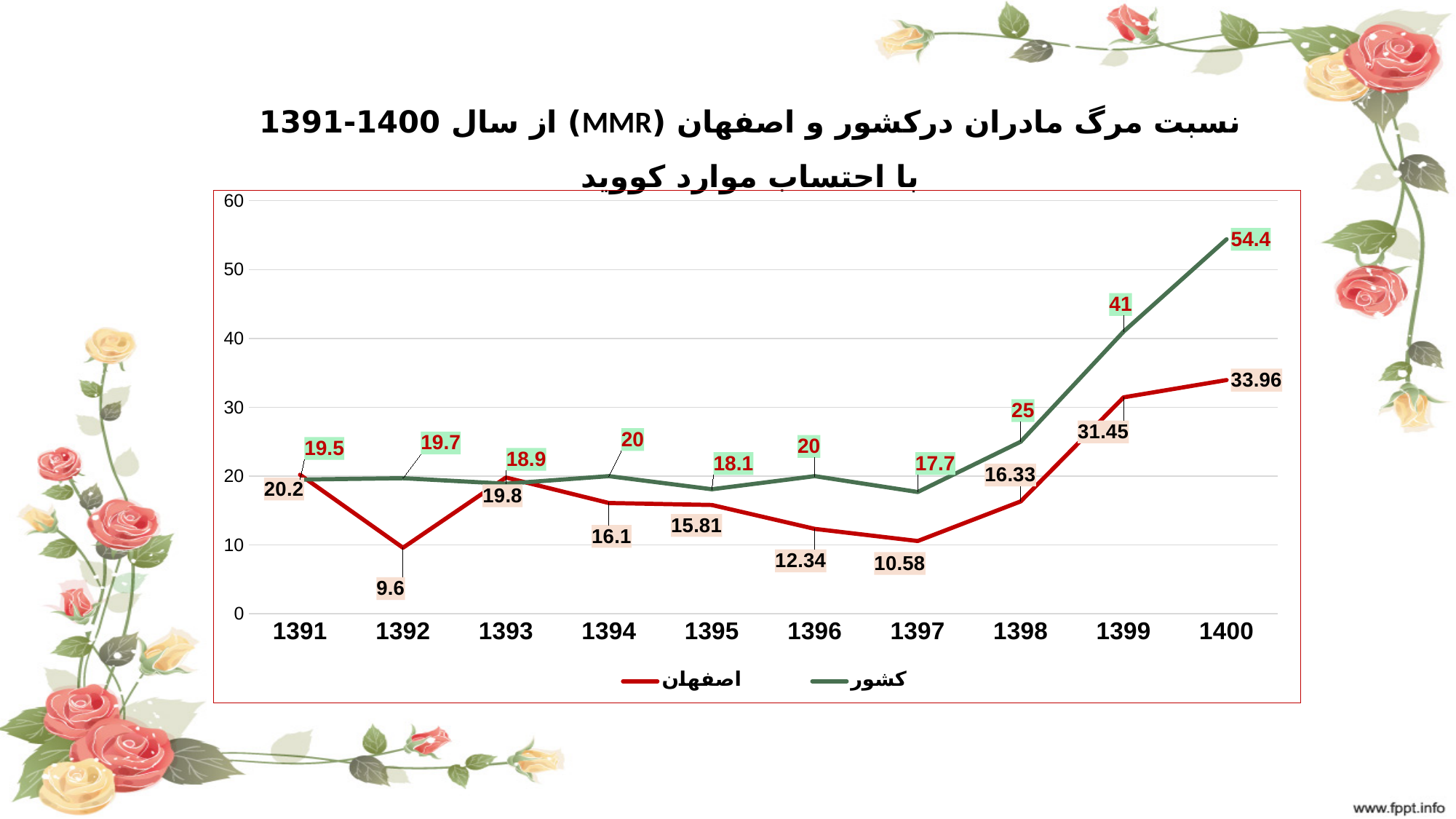
What is the value for کشور in 1400? 54.4 In which year is the کشور series highest? 1400 What colour is the line for اصفهان? red Which series has the larger value in 1399, اصفهان or کشور? کشور How many series does the legend list? 2 What type of chart is shown on the slide? line chart In which year is the اصفهان series lowest? 1392 What is the value for اصفهان in 1397? 10.58 Does the کشور series rise or fall from 1397 to 1400? rise How many years are shown on the x axis? 10 What is the value for اصفهان in 1392? 9.6 What is the difference between the کشور and اصفهان values in 1400? 20.44